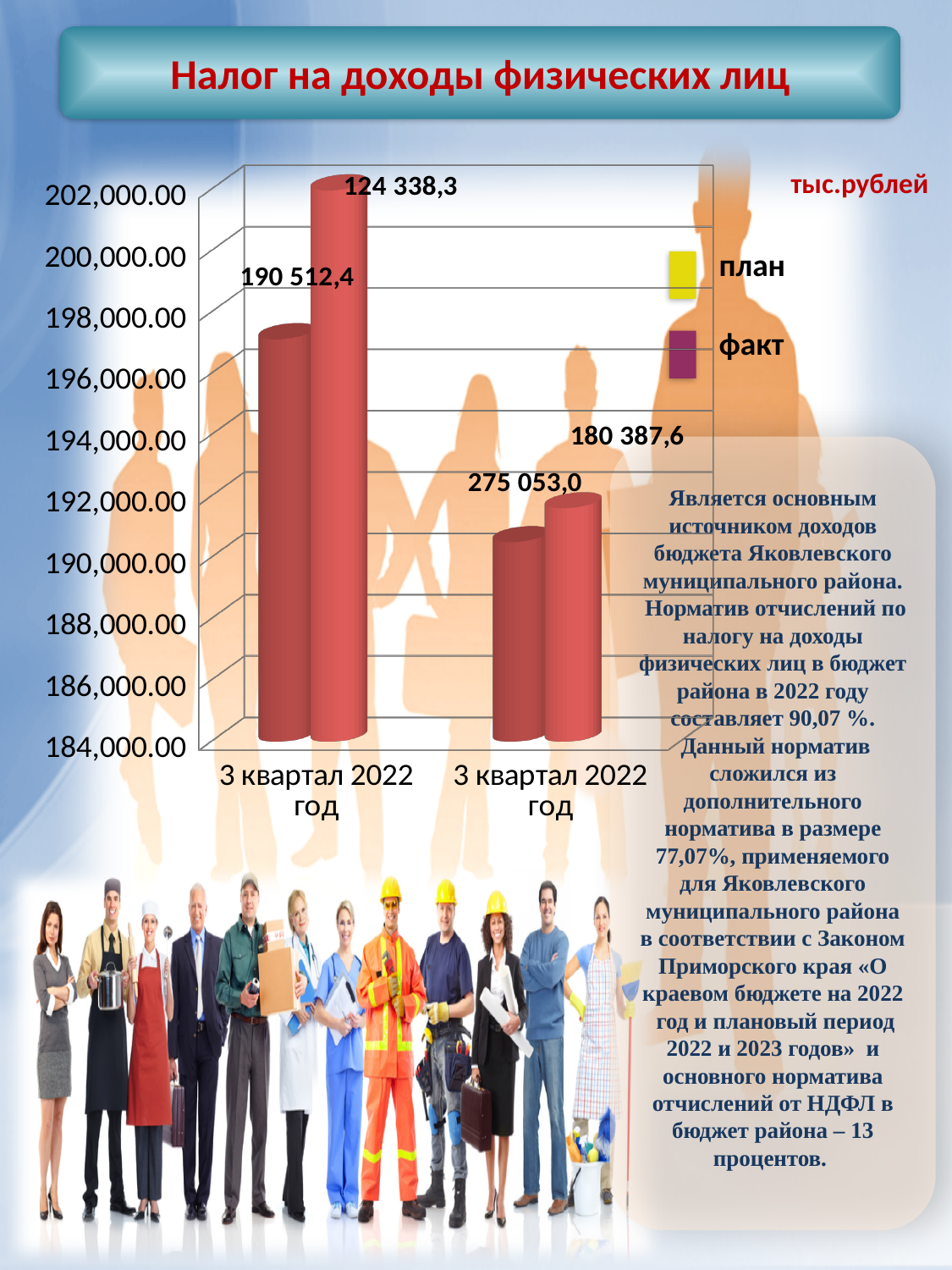
What is the highest value shown on the vertical axis of the chart? 202,000.00 How many category groups are shown along the x axis of the chart? 2 What are the two entries in the chart legend? план, факт What is the title shown above the chart? Налог на доходы физических лиц How many series does the chart legend list? 2 Is the shortest bar in the chart greater or less than 192,000.00 on the vertical axis? less What is the lowest value shown on the vertical axis of the chart? 184,000.00 Are the bars in the left category group taller or shorter than the bars in the right category group? taller What kind of chart is shown on the slide? bar chart What value label is printed at the top of the tallest bar in the chart? 124 338,3 What value label is printed above the shortest bar in the chart? 275 053,0 Is the tallest bar in the chart greater or less than 200,000.00 on the vertical axis? greater